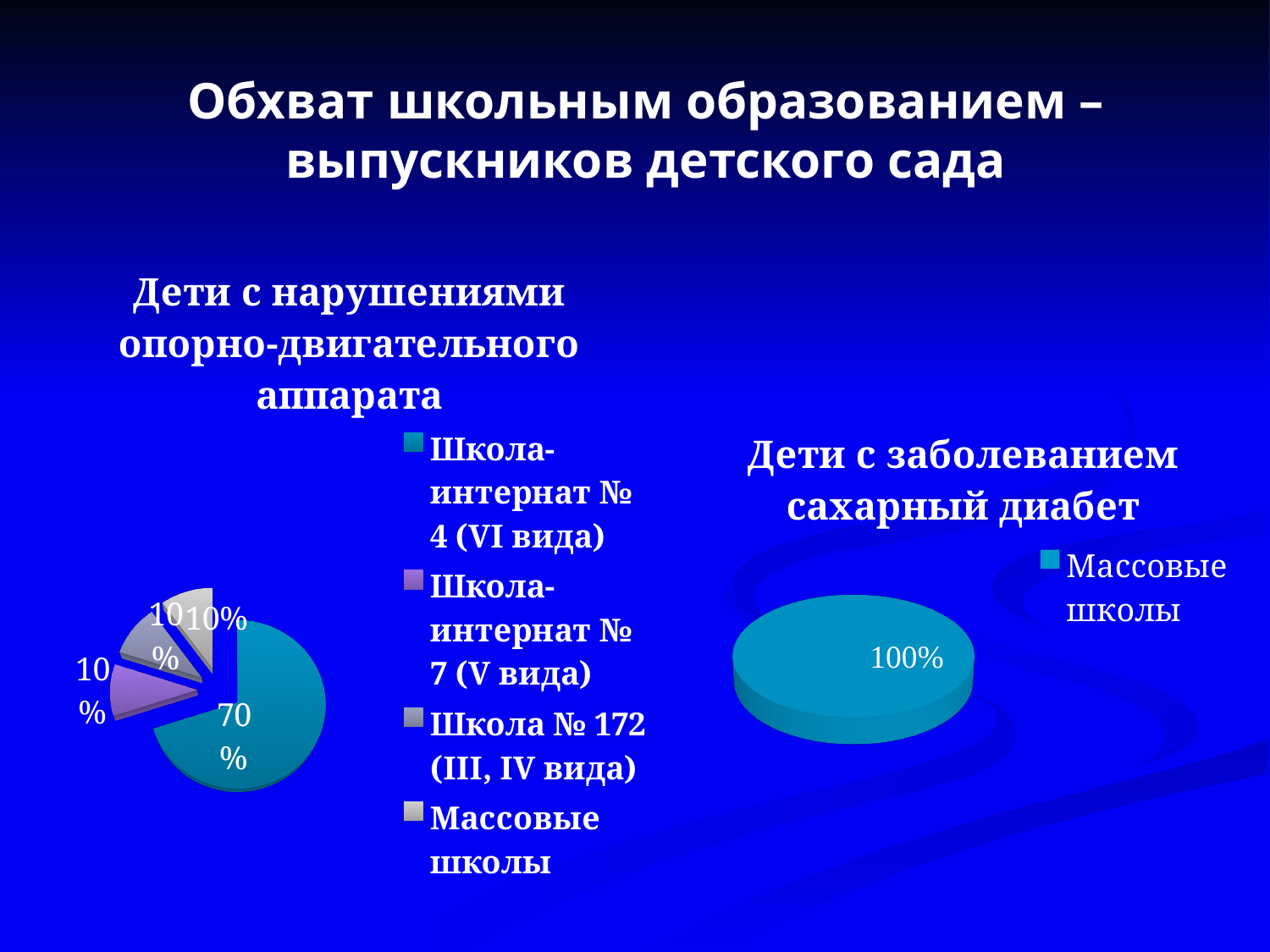
How many charts are shown on the slide? 2 In the chart titled "Дети с нарушениями опорно-двигательного аппарата", which is larger: Школа-интернат № 4 (VI вида) or Школа-интернат № 7 (V вида)? Школа-интернат № 4 (VI вида) In the chart titled "Дети с нарушениями опорно-двигательного аппарата", how many legend entries are there? 4 In the chart titled "Дети с нарушениями опорно-двигательного аппарата", what is the value for Массовые школы? 10% In the chart titled "Дети с нарушениями опорно-двигательного аппарата", how many slices does the pie have? 4 In the chart titled "Дети с нарушениями опорно-двигательного аппарата", which category has the largest slice? Школа-интернат № 4 (VI вида) What kind of chart is the one titled "Дети с заболеванием сахарный диабет"? Pie chart In the chart titled "Дети с нарушениями опорно-двигательного аппарата", what is the difference between the Школа-интернат № 4 (VI вида) slice and the Школа № 172 (III, IV вида) slice? 60% In the chart titled "Дети с заболеванием сахарный диабет", what share of the pie is Массовые школы? 100% In the chart titled "Дети с заболеванием сахарный диабет", how many categories does the legend list? 1 What kind of chart is the one titled "Дети с нарушениями опорно-двигательного аппарата"? Pie chart In the chart titled "Дети с нарушениями опорно-двигательного аппарата", what share of the pie is Школа-интернат № 4 (VI вида)? 70%